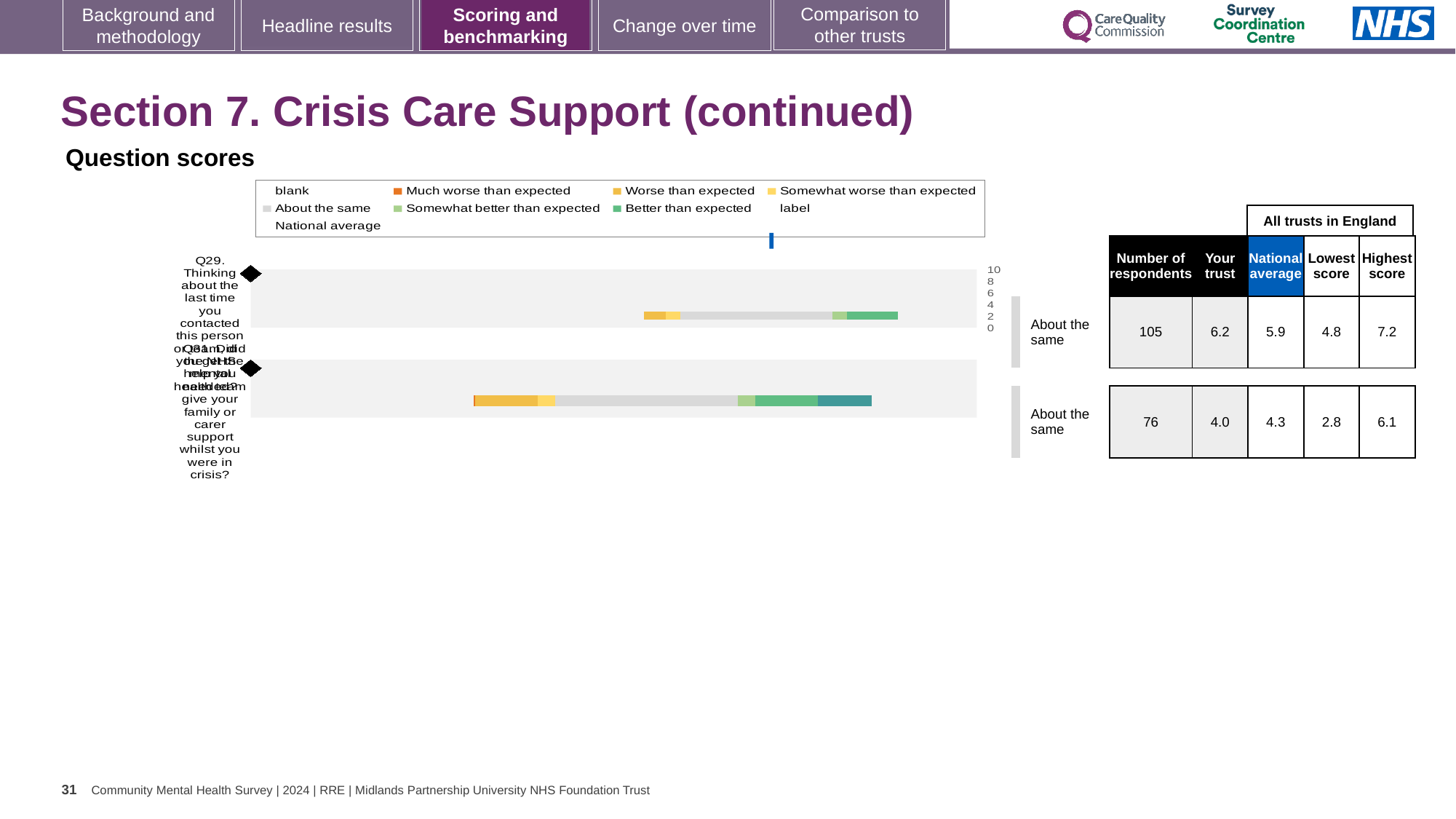
How many respondents answered Q31? 76 What is the difference between the national average and the 'Your trust' score for Q31? 0.3 What colour does the legend use for 'Much worse than expected'? orange What is the national average for Q31? 4.3 What is the lowest score across all trusts in England for Q31? 2.8 For Q29, which is higher: the 'Your trust' score or the national average? Your trust What colour does the legend use for 'About the same'? grey Which question has more respondents, Q29 or Q31? Q29 What kind of chart is shown under 'Question scores'? bar chart What is the 'Your trust' score for Q29? 6.2 What is the difference between the highest score and the lowest score for Q29? 2.4 How many question bars are plotted in the chart? 2